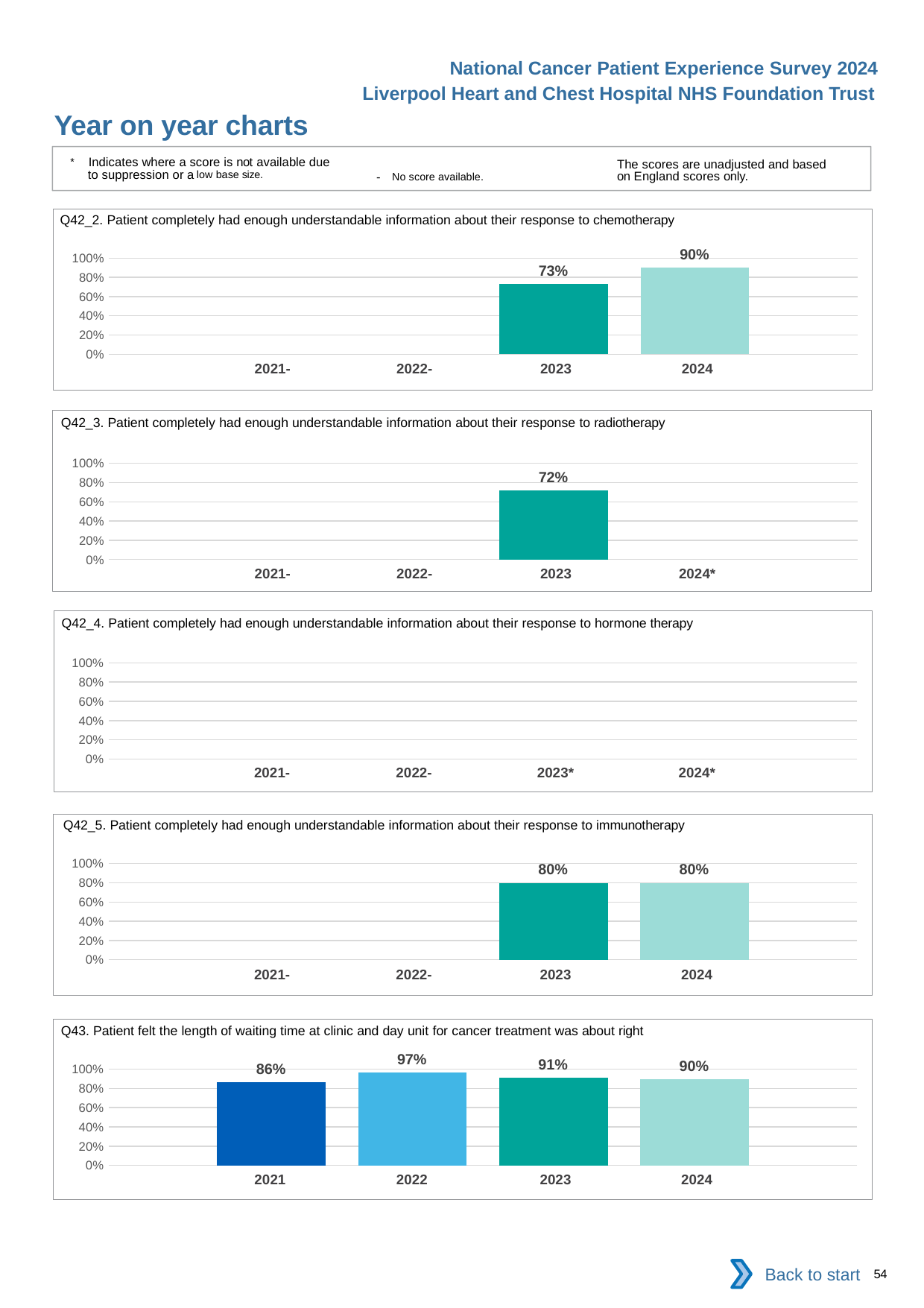
In the Q42_2 chart (chemotherapy), what is the difference between the 2024 and 2023 values? 17 percentage points What type of chart is the Q43 chart (waiting time at clinic and day unit)? Bar chart In the Q42_2 chart (chemotherapy), what is the value for 2023? 73% In the Q42_3 chart (radiotherapy), how many bars are plotted? 1 In the Q42_4 chart (hormone therapy), how many bars are plotted? 0 In the Q43 chart (waiting time at clinic and day unit), which year has the lowest value? 2021 In the Q42_2 chart (chemotherapy), what is the value for 2024? 90% In the Q43 chart (waiting time at clinic and day unit), what is the difference between the 2022 and 2021 values? 11 percentage points In the Q42_3 chart (radiotherapy), what is the value for 2023? 72% In the Q43 chart (waiting time at clinic and day unit), what is the value for 2023? 91% In the Q42_5 chart (immunotherapy), what is the value for 2024? 80% In the Q43 chart (waiting time at clinic and day unit), which year has the highest value? 2022